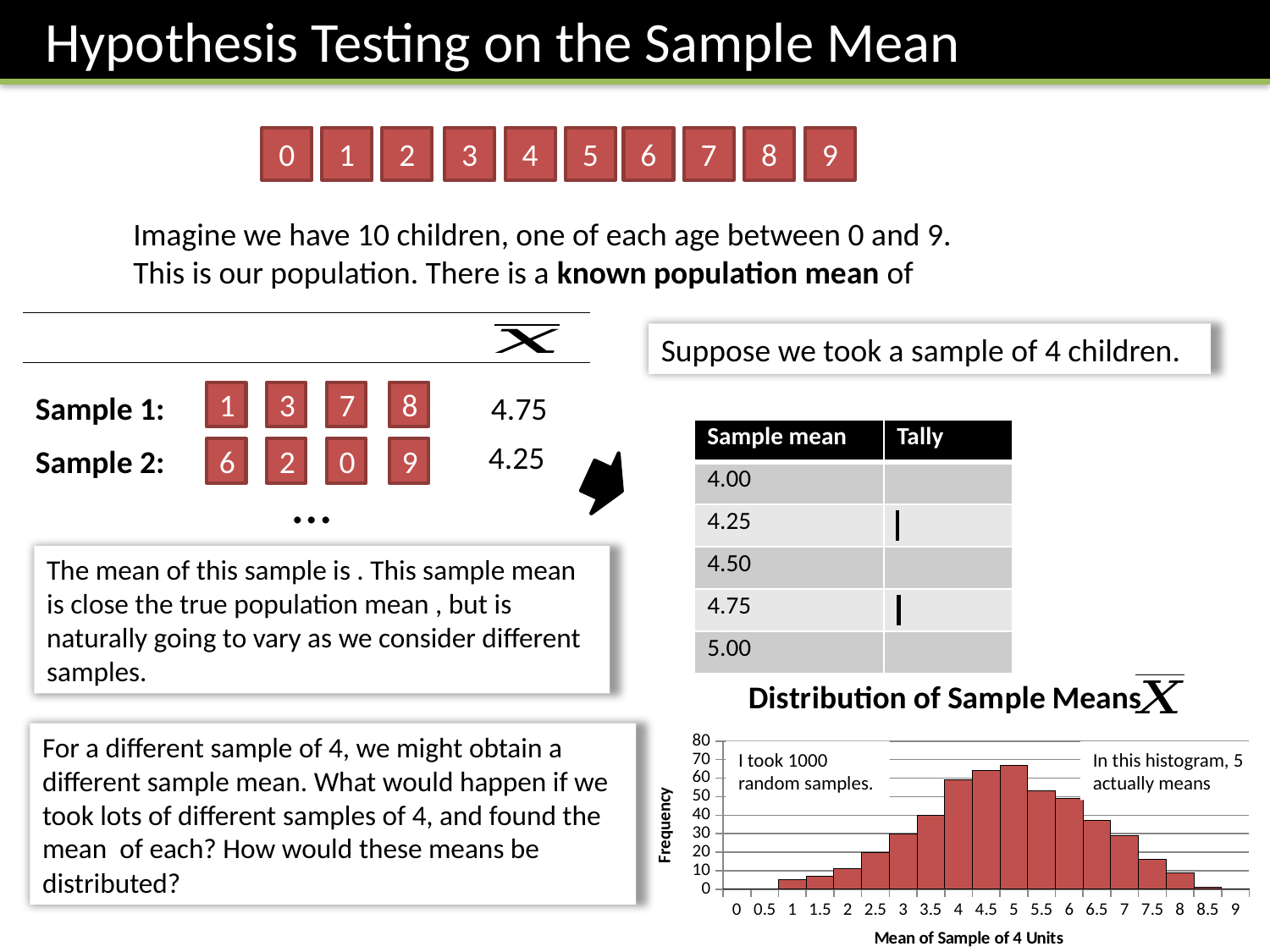
In the "Distribution of Sample Means" chart, is the frequency for a sample mean of 3 greater or less than 40? less In the "Distribution of Sample Means" chart, which has the higher frequency: a sample mean of 4 or a sample mean of 7? 4 In the "Distribution of Sample Means" chart, is the frequency for a sample mean of 4 greater or less than 50? greater What kind of chart is shown under the title "Distribution of Sample Means"? bar chart In the "Distribution of Sample Means" chart, is the frequency for a sample mean of 5 greater or less than 60? greater In the "Distribution of Sample Means" chart, which sample mean has the highest frequency? 5 In the "Distribution of Sample Means" chart, which has the higher frequency: a sample mean of 3 or a sample mean of 6? 6 In the "Distribution of Sample Means" chart, do the frequencies rise or fall as the sample mean increases from 1 to 5? rise What is the label on the x axis of the "Distribution of Sample Means" chart? Mean of Sample of 4 Units What is the label on the y axis of the "Distribution of Sample Means" chart? Frequency